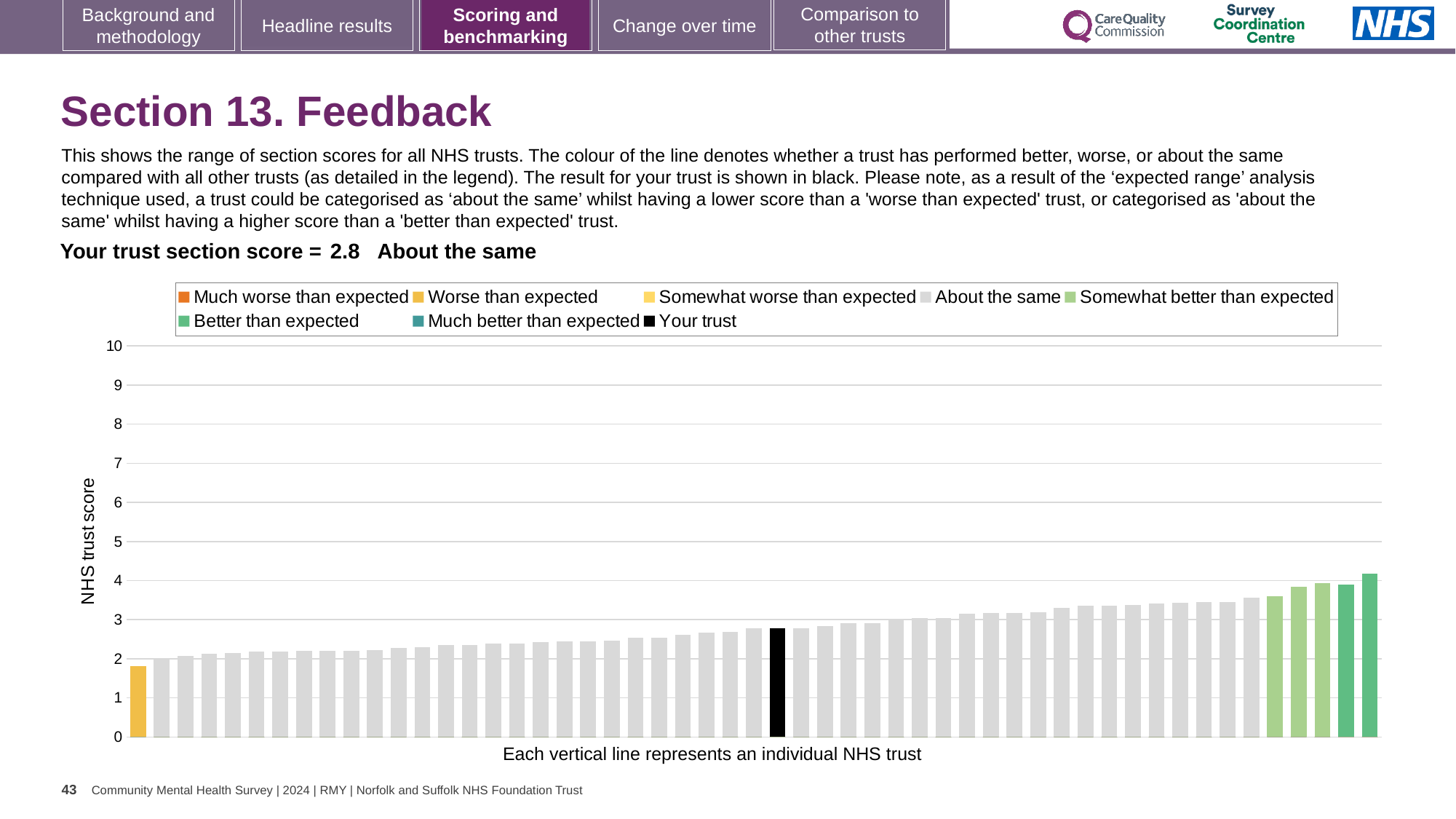
Is the value of the leftmost (yellow) bar greater or less than 2? less Is the value of the rightmost bar greater or less than 3? greater What kind of chart is shown on the slide? bar chart Is the value for your trust greater or less than 5? less Do the bar values rise or fall from left to right across the chart? rise What is the label on the vertical axis of the chart? NHS trust score What is the section score for your trust shown on the slide? 2.8 Which performance category is your trust placed in for Section 13 Feedback? About the same What colour is the bar representing your trust? black How many entries does the chart legend list? 8